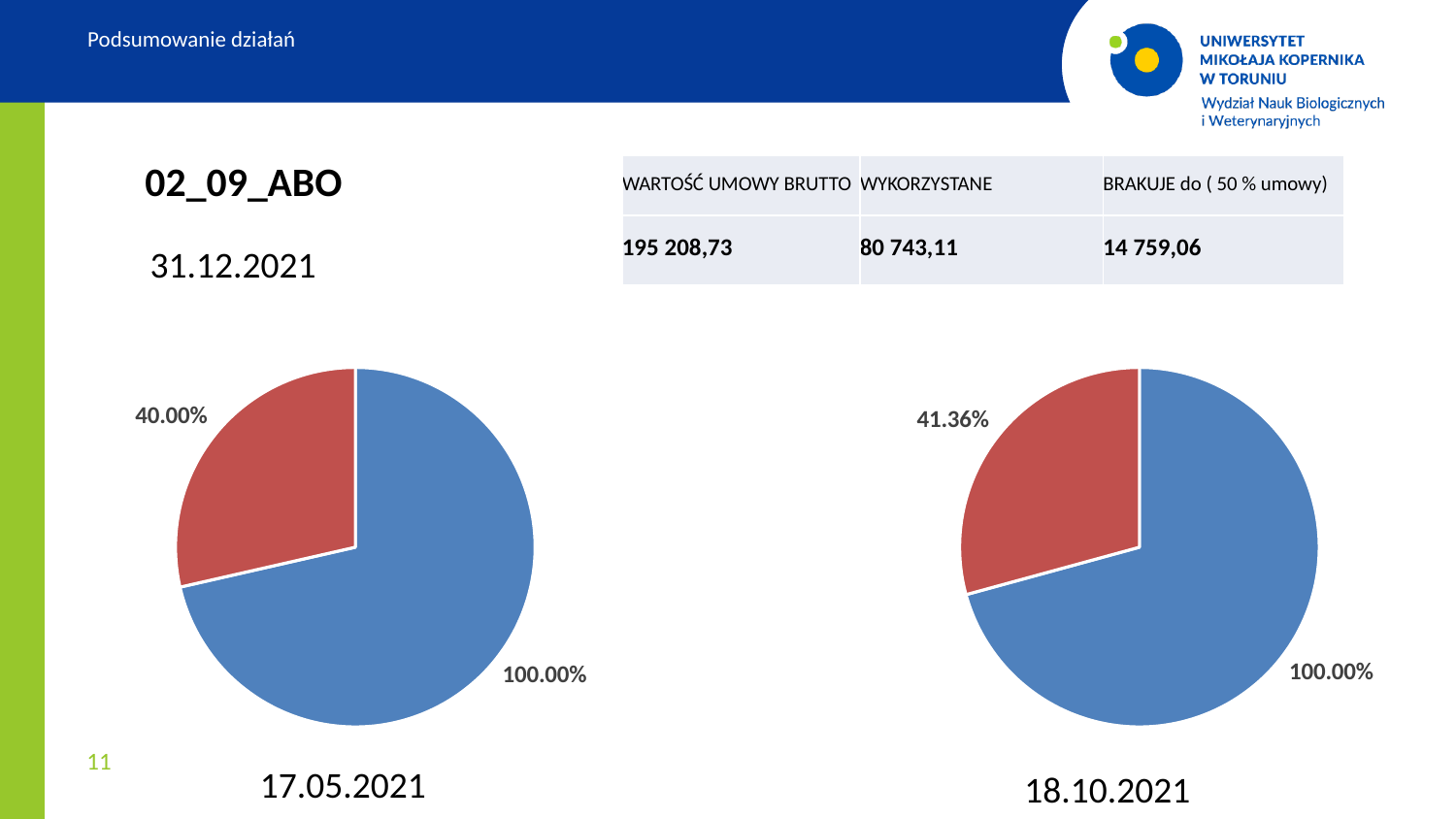
In the right pie chart (18.10.2021), what value is printed next to the blue slice? 100.00% In the left pie chart (17.05.2021), what value is printed next to the red slice? 40.00% In the left pie chart (17.05.2021), what value is printed next to the blue slice? 100.00% What date is printed below the left pie chart? 17.05.2021 How many slices does the left pie chart (17.05.2021) have? 2 What kind of chart is shown on the right side of the slide (18.10.2021)? pie chart What kind of chart is shown on the left side of the slide (17.05.2021)? pie chart Which slice is larger in the left pie chart (17.05.2021), the blue one or the red one? the blue one What colour is the smaller slice in the right pie chart (18.10.2021)? red How many slices does the right pie chart (18.10.2021) have? 2 In the right pie chart (18.10.2021), what value is printed next to the red slice? 41.36% Which is larger: the red slice label in the left pie chart (17.05.2021) or the red slice label in the right pie chart (18.10.2021)? the right pie chart (41.36%)